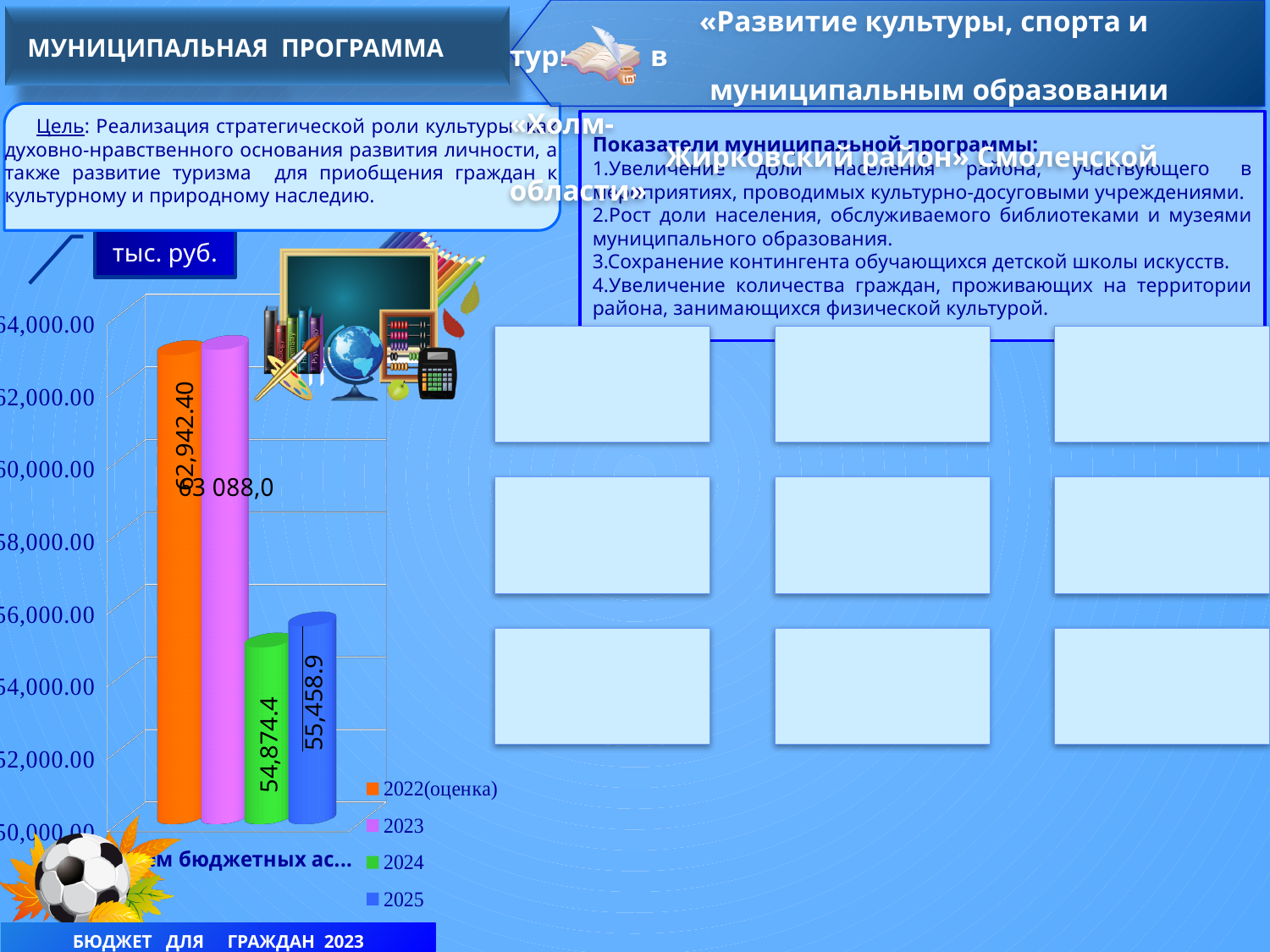
What is the value for 2025 in the bar chart? 55,458.9 Is the value for 2024 greater or less than 56,000.00? less What is the value for 2022(оценка) in the bar chart? 62,942.40 What is the value for 2023 in the bar chart? 63 088,0 What unit is shown in the label above the chart? тыс. руб. How many series does the legend list? 4 What is the difference between the values for 2025 and 2024? 584.5 Which is larger, the value for 2022(оценка) or the value for 2024? 2022(оценка) What kind of chart is shown on the slide? bar chart Which year has the highest value in the bar chart? 2023 Which year has the lowest value in the bar chart? 2024 What is the value for 2024 in the bar chart? 54,874.4